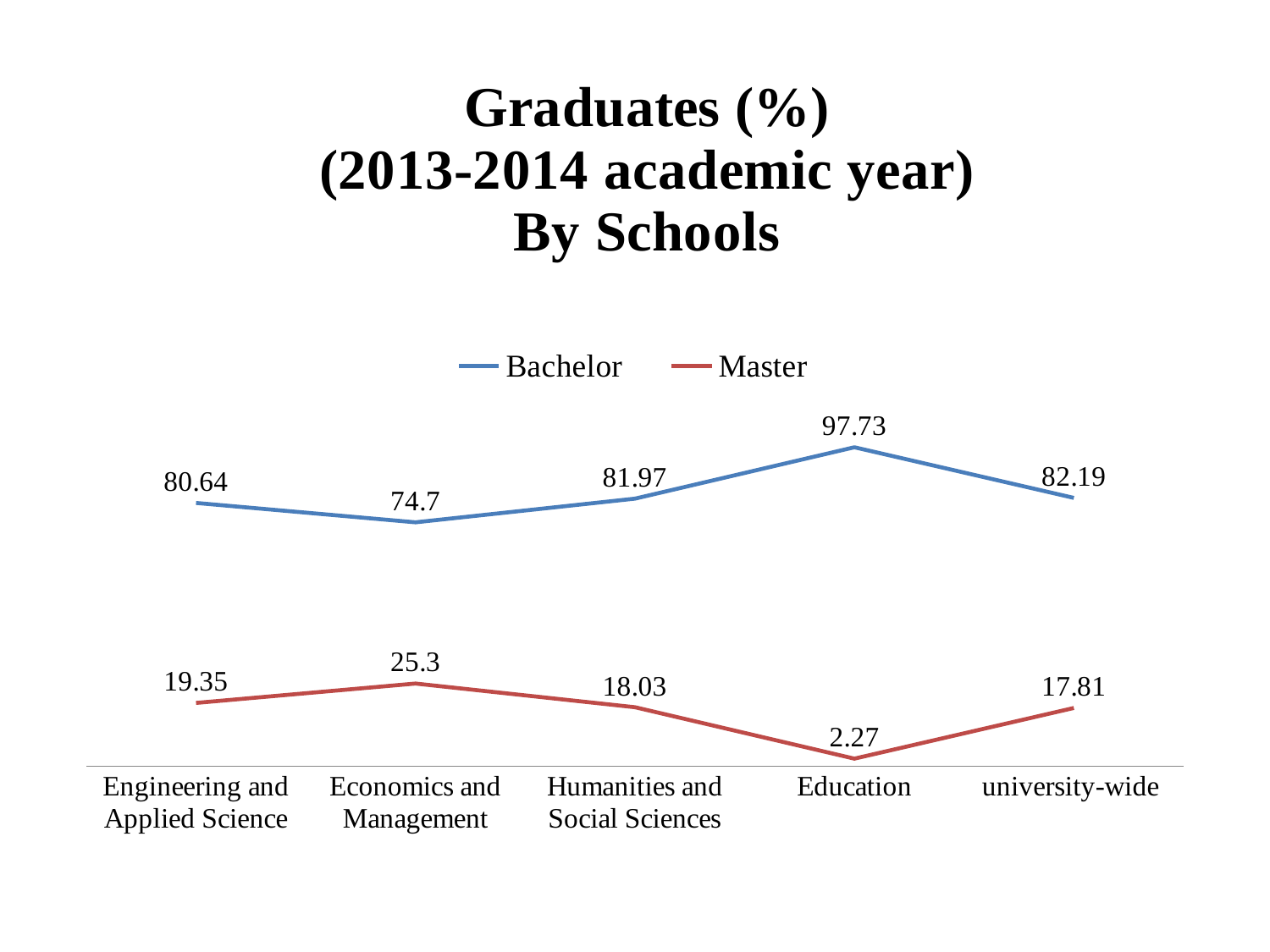
What is the difference between the Bachelor and Master values for Engineering and Applied Science? 61.29 What is the Bachelor value for university-wide? 82.19 Which category has the lowest Bachelor value? Economics and Management Which school has the lowest Master value? Education How many series does the legend list? 2 What kind of chart is this? Line chart Which is larger, the Master value for Humanities and Social Sciences or the Master value for university-wide? Humanities and Social Sciences What is the Bachelor value for Education? 97.73 What is the Master value for Education? 2.27 What is the Master value for Economics and Management? 25.3 Which school has the highest Bachelor value? Education How many categories are shown on the x axis? 5